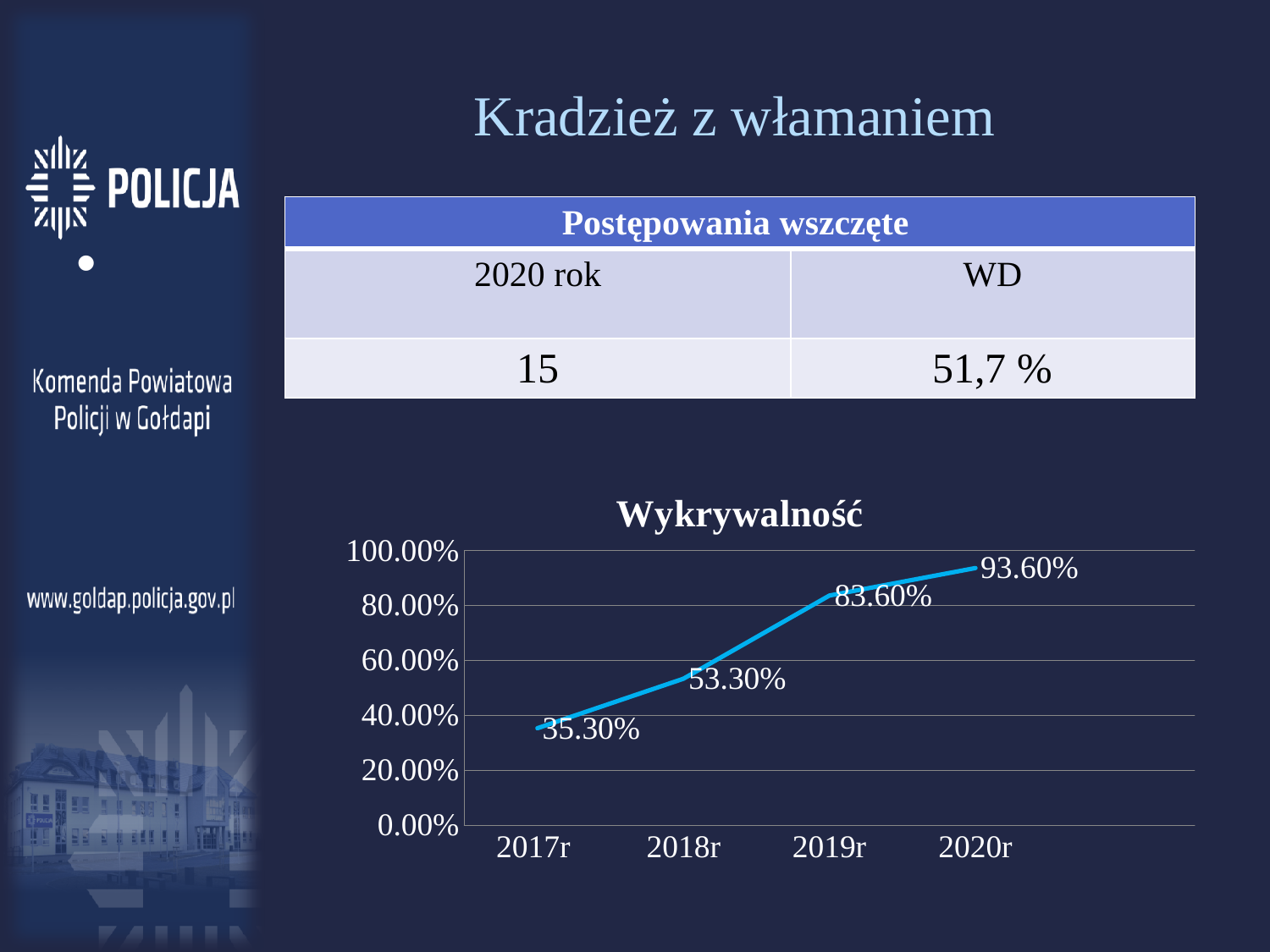
Which is larger in the Wykrywalność chart, the value for 2018r or 2019r? 2019r What is the value for 2018r in the Wykrywalność chart? 53.30% What is the difference between the 2020r and 2017r values in the Wykrywalność chart? 58.30% Do the values in the Wykrywalność chart rise or fall from 2017r to 2020r? rise What is the value for 2019r in the Wykrywalność chart? 83.60% Which year has the lowest value in the Wykrywalność chart? 2017r How many years are plotted in the Wykrywalność chart? 4 What is the value for 2017r in the Wykrywalność chart? 35.30% What is the value for 2020r in the Wykrywalność chart? 93.60% Which year has the highest value in the Wykrywalność chart? 2020r What kind of chart is the Wykrywalność chart? line chart What is the difference between the 2019r and 2018r values in the Wykrywalność chart? 30.30%